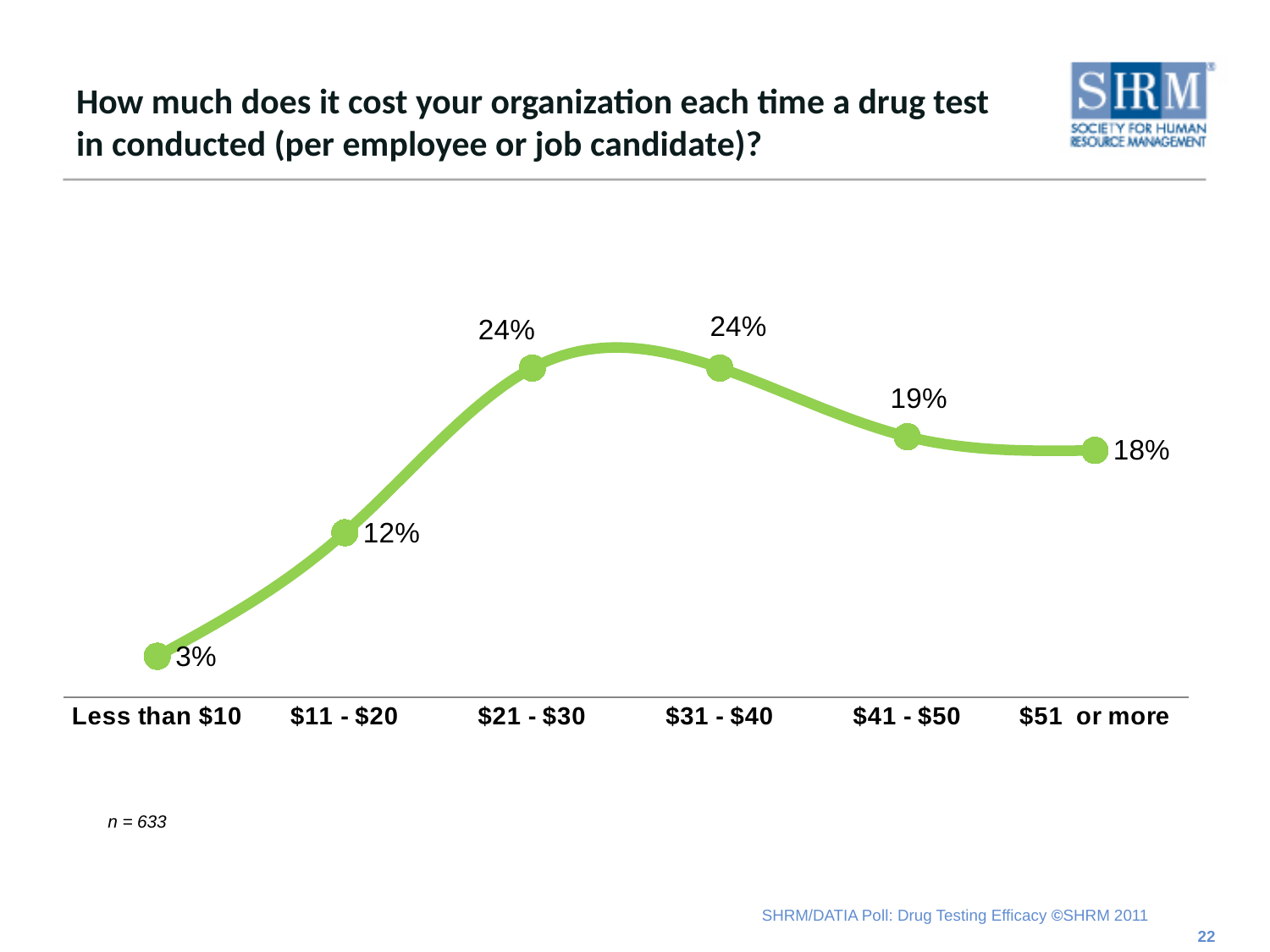
Which is larger, the value for $31 - $40 or the value for $41 - $50? $31 - $40 What percentage of organizations report a drug test cost of $51 or more? 18% Which cost category has the lowest percentage? Less than $10 What percentage of organizations report a drug test cost of less than $10? 3% What is the difference in percentage points between the $41 - $50 category and the $51 or more category? 1 Do the values rise or fall from the 'Less than $10' category to the '$21 - $30' category? Rise What percentage of organizations report a drug test cost of $41 - $50? 19% What is the sample size (n) noted below the chart? n = 633 What kind of chart is shown on the slide? Line chart What is the difference in percentage points between the $21 - $30 category and the $11 - $20 category? 12 What percentage of organizations report a drug test cost of $11 - $20? 12% How many cost categories are shown on the x axis? 6